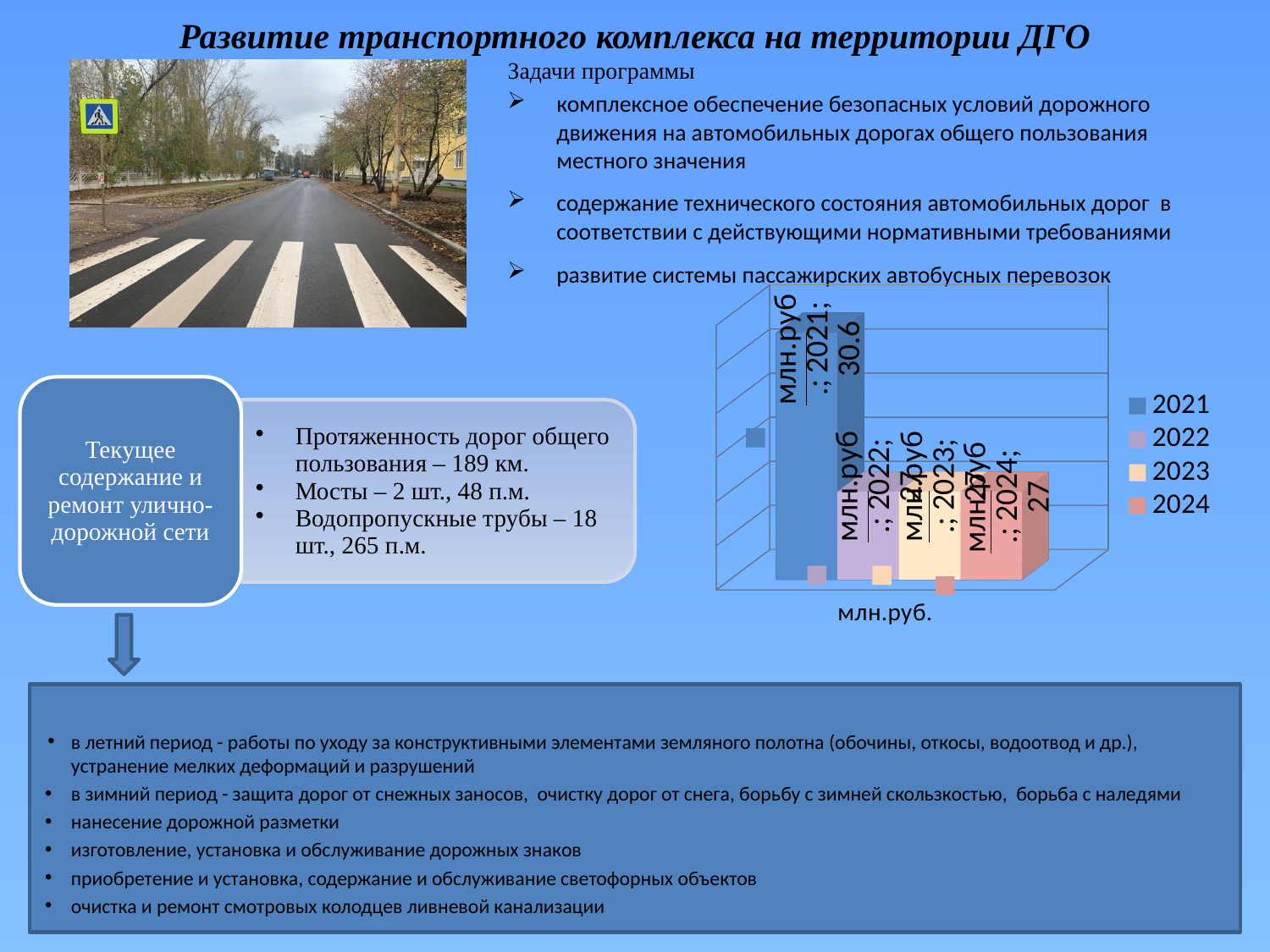
How many series does the chart legend list? 4 What label appears below the bars on the chart's horizontal axis? млн.руб. Which is larger in the chart, the value for 2021 or the value for 2022? 2021 What kind of chart is shown on the slide? bar chart What entries are listed in the chart legend? 2021, 2022, 2023, 2024 What is the difference between the 2021 value and the 2024 value in the chart? 3.6 What is the value for 2021 in the chart? 30.6 How many bars are plotted in the chart? 4 Which is larger in the chart, the value for 2021 or the value for 2024? 2021 What is the value for 2024 in the chart? 27 Which year has the highest value in the chart? 2021